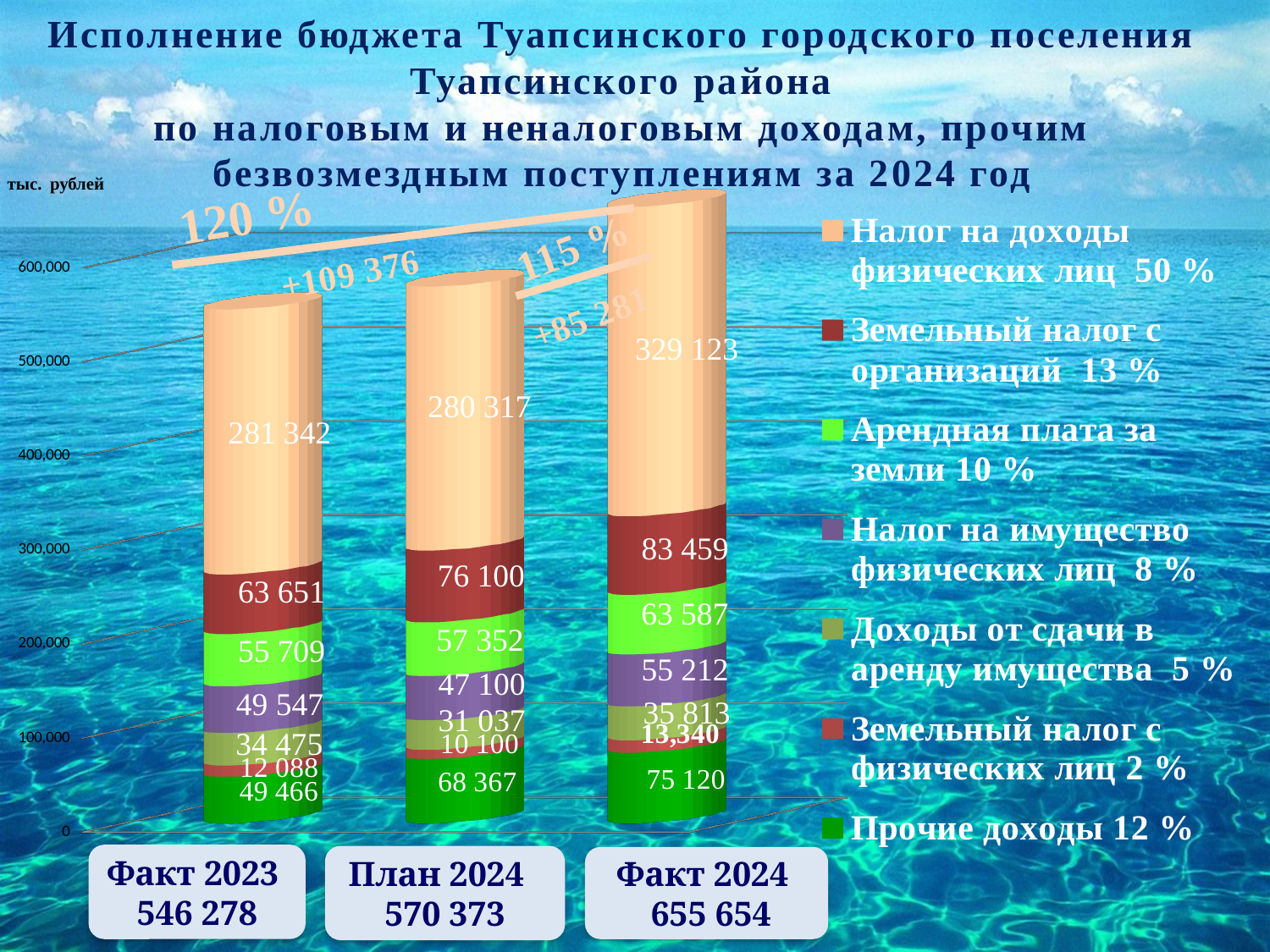
What is the value of Налог на доходы физических лиц for Факт 2024? 329 123 How many bars (categories) does the chart show? 3 What percentage share does the legend give for Налог на доходы физических лиц? 50 % What is the difference between Налог на доходы физических лиц for Факт 2024 and Факт 2023? 47 781 Which is larger for Земельный налог с организаций: План 2024 or Факт 2024? Факт 2024 How many series does the legend list? 7 Which bar has the highest total? Факт 2024 What is the value of Прочие доходы for План 2024? 68 367 What is the total of the Факт 2024 bar? 655 654 What kind of chart is shown on the slide? Stacked bar chart Do the bar totals rise or fall from Факт 2023 to Факт 2024? Rise What is the value of Земельный налог с физических лиц for Факт 2023? 12 088